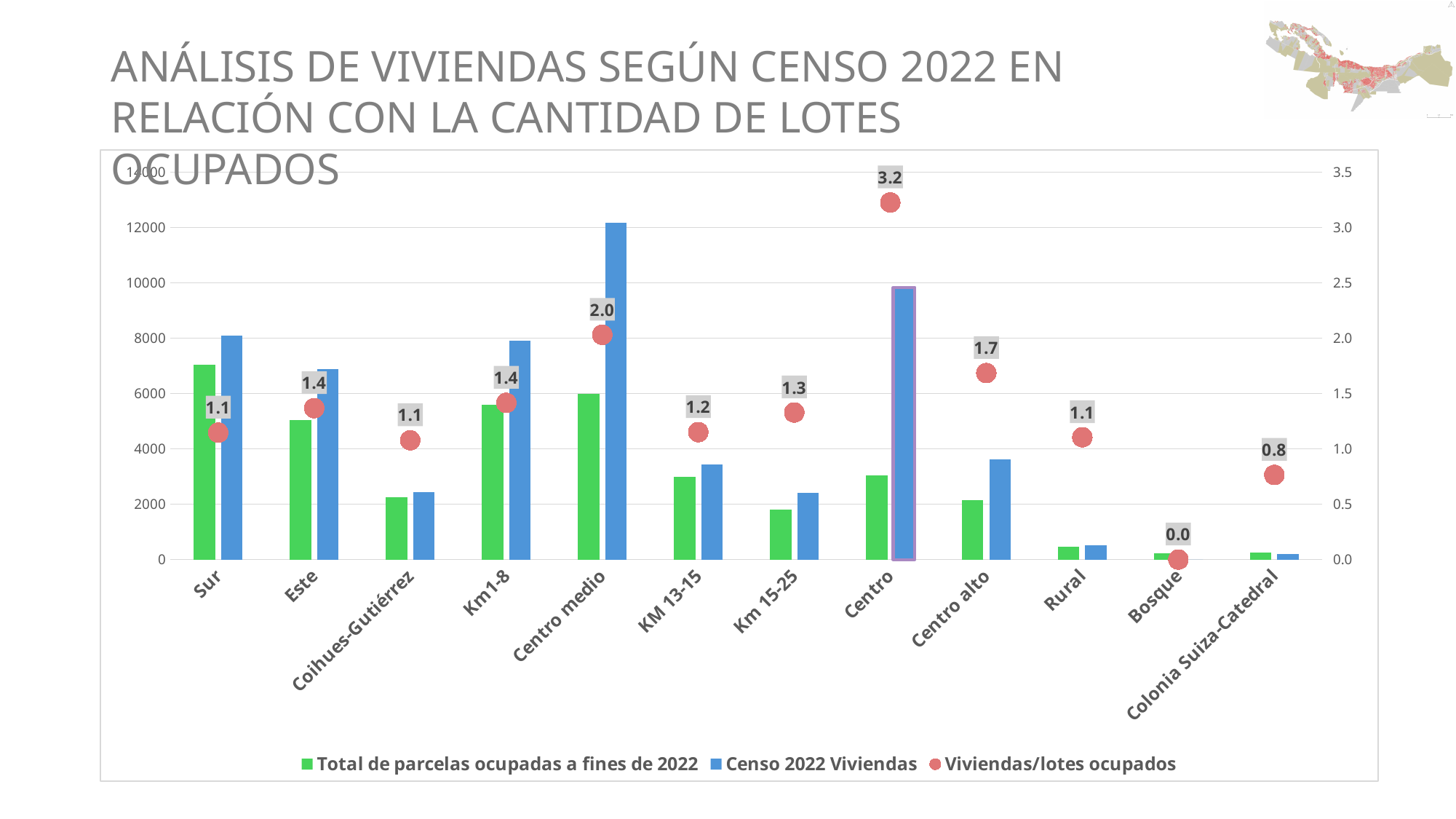
What is the difference between the Viviendas/lotes ocupados values for Centro and Centro alto? 1.5 What is the Viviendas/lotes ocupados value for Centro? 3.2 How many series does the legend list? 3 What is the Viviendas/lotes ocupados value for Centro medio? 2.0 Which category has the tallest Total de parcelas ocupadas a fines de 2022 bar? Sur Is the Censo 2022 Viviendas value for Centro medio greater or less than 10000? greater Which category has the highest Viviendas/lotes ocupados value? Centro How many categories are shown on the x axis? 12 Which category has the lowest Viviendas/lotes ocupados value? Bosque Which category has the tallest Censo 2022 Viviendas bar? Centro medio Is the Total de parcelas ocupadas a fines de 2022 value for Km 15-25 greater or less than 2000? less What is the Viviendas/lotes ocupados value for Colonia Suiza-Catedral? 0.8